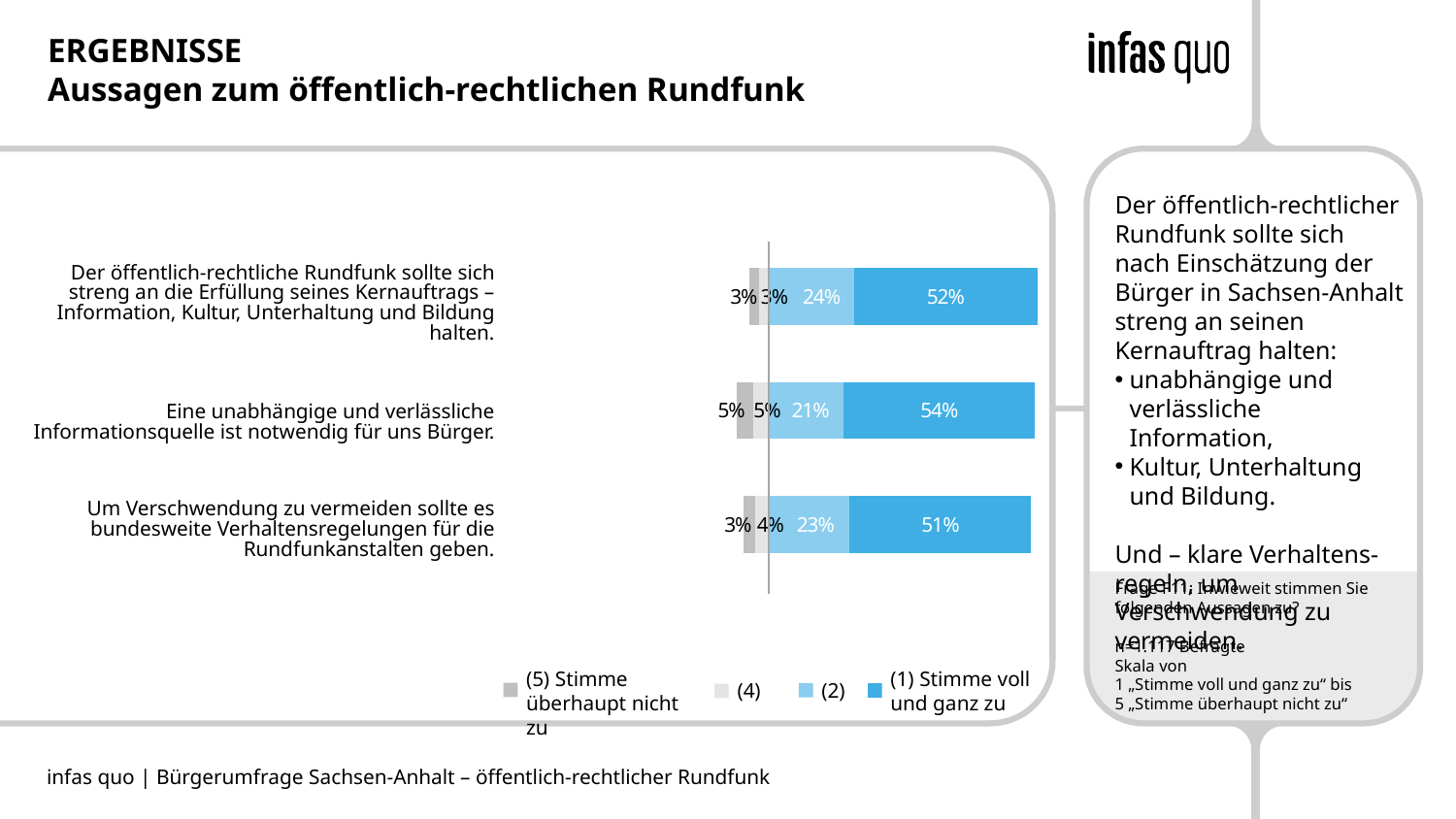
How many statements (categories) are plotted in the chart? 3 How many series does the chart legend list? 4 What is the value of the "(5) Stimme überhaupt nicht zu" segment for the statement "Um Verschwendung zu vermeiden sollte es bundesweite Verhaltensregelungen für die Rundfunkanstalten geben."? 3% What is the value of the "(4)" segment for the statement "Eine unabhängige und verlässliche Informationsquelle ist notwendig für uns Bürger."? 5% Which is larger: the "(2)" share for the Kernauftrag statement or the "(2)" share for the Informationsquelle statement? Kernauftrag statement (24%) What is the difference between the "(1) Stimme voll und ganz zu" shares for the Informationsquelle statement and the Verschwendung statement? 3% What kind of chart is shown on the slide? stacked bar chart What share of respondents answered "(1) Stimme voll und ganz zu" for the statement "Eine unabhängige und verlässliche Informationsquelle ist notwendig für uns Bürger."? 54% What is the total of the printed segments in the bar for the statement "Eine unabhängige und verlässliche Informationsquelle ist notwendig für uns Bürger."? 85% What is the value of the "(2)" segment for the statement about the Rundfunk sticking strictly to its Kernauftrag? 24% Which statement has the highest share of "(1) Stimme voll und ganz zu"? Eine unabhängige und verlässliche Informationsquelle ist notwendig für uns Bürger. Which statement has the lowest share of "(1) Stimme voll und ganz zu"? Um Verschwendung zu vermeiden sollte es bundesweite Verhaltensregelungen für die Rundfunkanstalten geben.